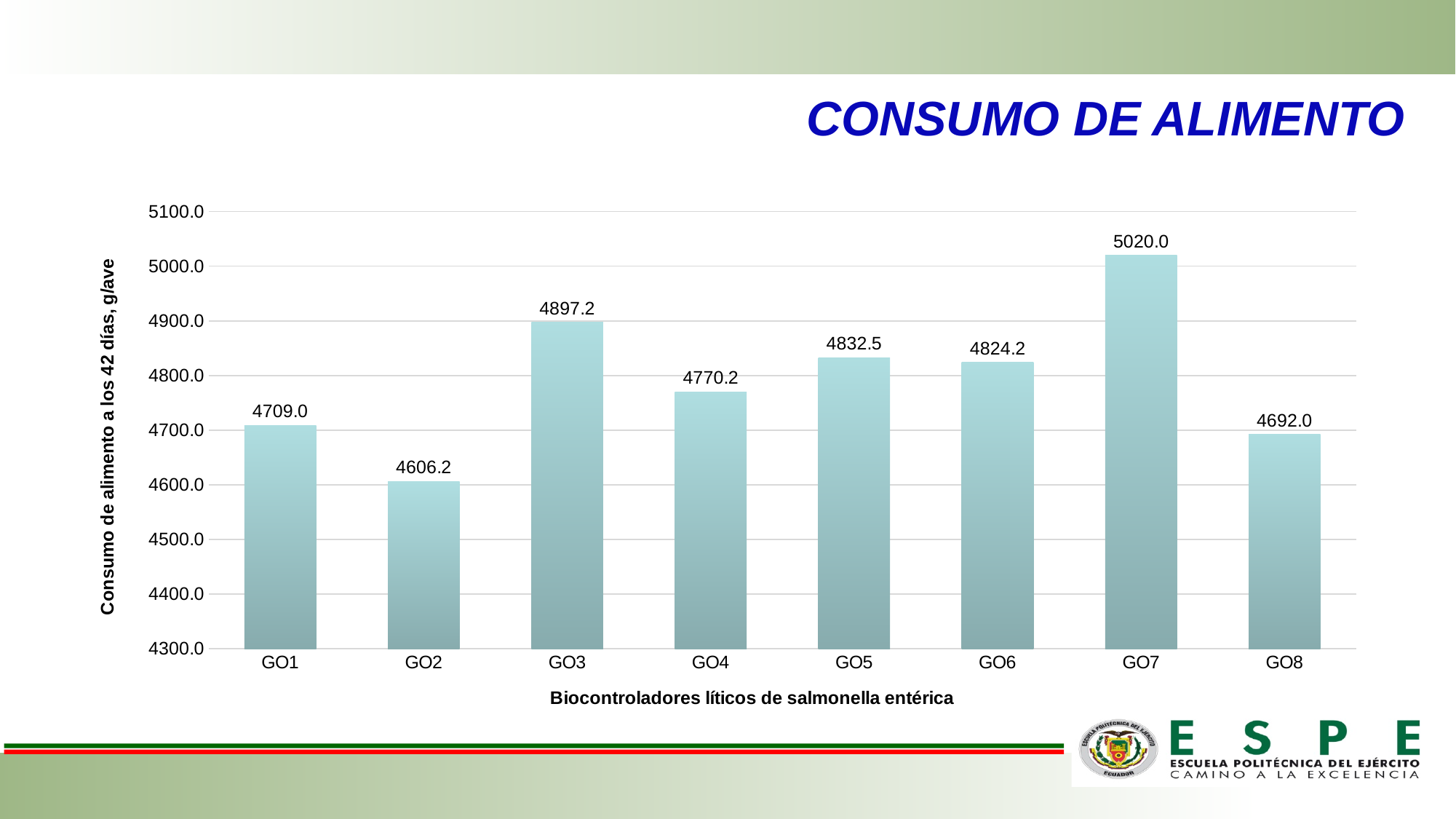
What is the value for GO5? 4832.5 What is the difference between the values for GO7 and GO2? 413.8 How many categories are shown on the x axis? 8 Which category has the lowest value? GO2 What is the value for GO3? 4897.2 What is the title of the chart? CONSUMO DE ALIMENTO Which category has the highest value? GO7 What kind of chart is shown on the slide? bar chart What is the value for GO8? 4692.0 Is the value for GO3 greater or less than 4800.0? greater Which is larger, the value for GO4 or the value for GO6? GO6 What is the difference between the values for GO1 and GO8? 17.0